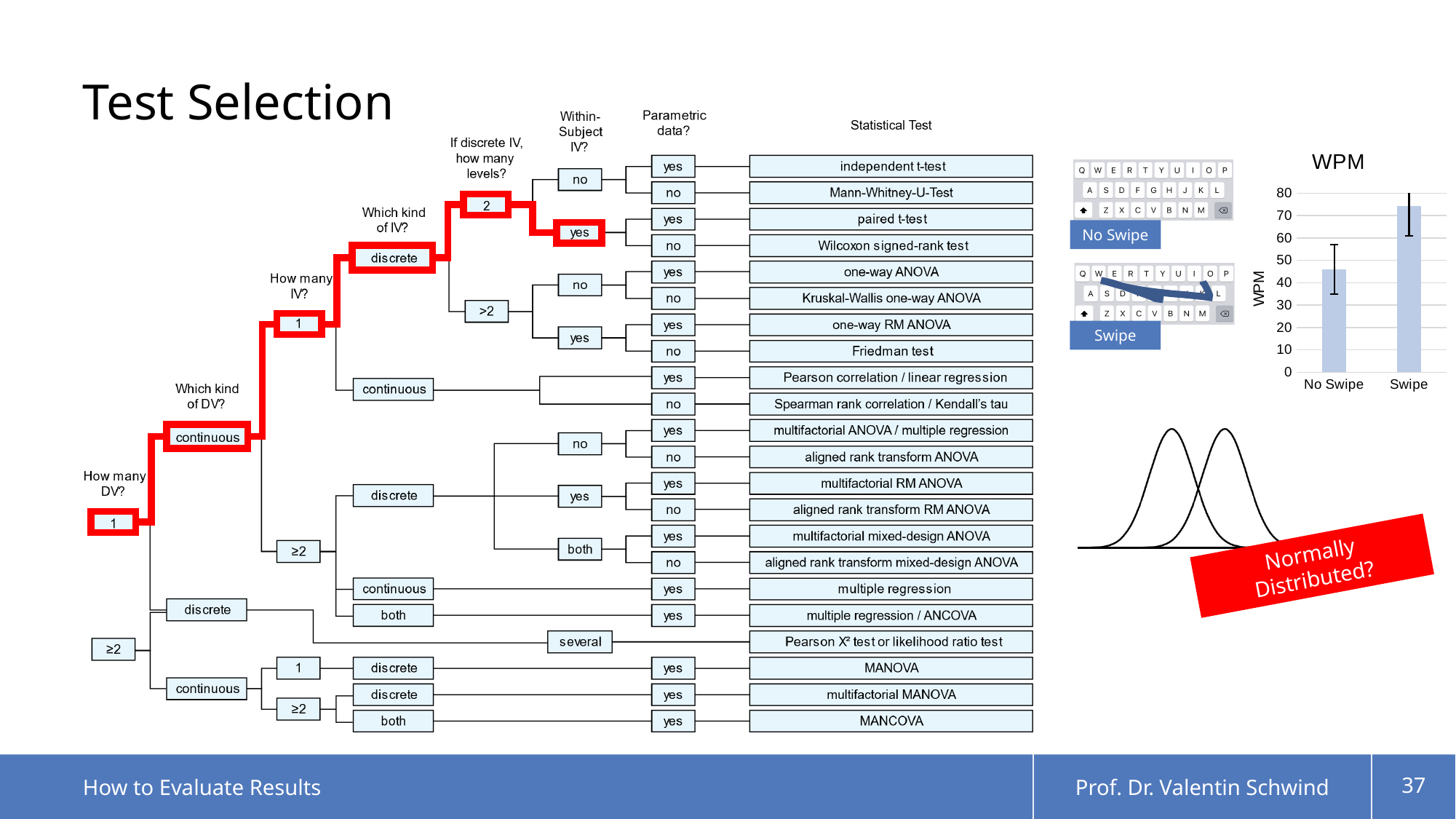
What kind of chart is the WPM chart? bar chart What is the title of the bar chart on the slide? WPM In the WPM chart, is the value for No Swipe greater or less than 40? greater Do the values in the WPM chart rise or fall from No Swipe to Swipe? rise In the WPM chart, is the value for Swipe greater or less than 80? less In the WPM chart, is the value for No Swipe greater or less than 50? less Which category has the lowest value in the WPM chart? No Swipe Which category has the highest value in the WPM chart? Swipe What is the label on the y axis of the WPM chart? WPM How many categories are shown on the x axis of the WPM chart? 2 In the WPM chart, which is larger, the value for No Swipe or the value for Swipe? Swipe